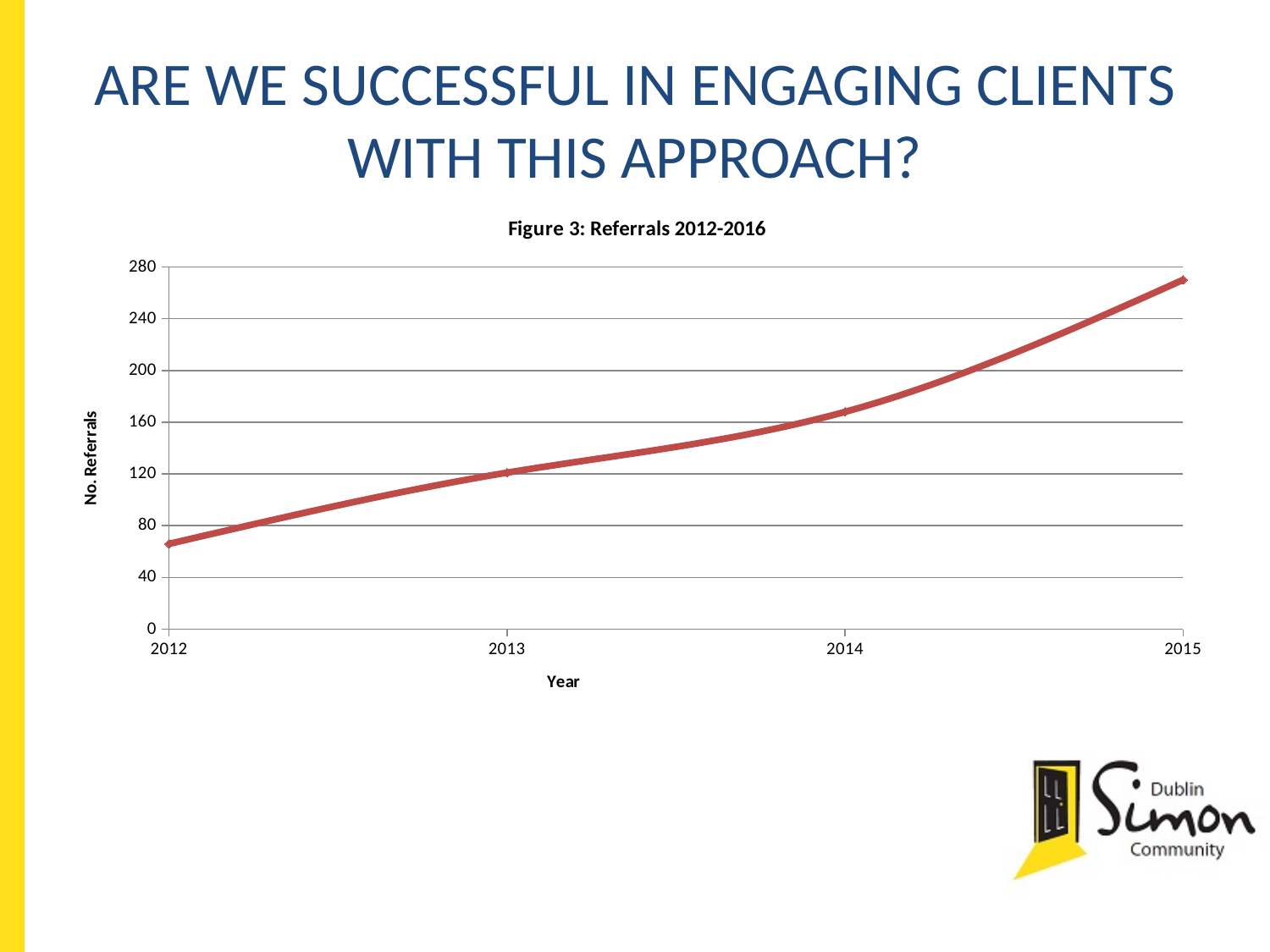
Is the number of referrals in 2015 greater or less than 240? greater Is the number of referrals in 2012 greater or less than 80? less What kind of chart is shown on the slide? line chart Is the number of referrals in 2014 greater or less than 160? greater Do the number of referrals rise or fall from 2012 to 2015? rise Which year has more referrals, 2013 or 2014? 2014 What is the label on the vertical axis of the chart? No. Referrals What is the title of the chart? Figure 3: Referrals 2012-2016 How many years are plotted on the x axis of the chart? 4 Which year has the lowest number of referrals? 2012 Which year has the highest number of referrals? 2015